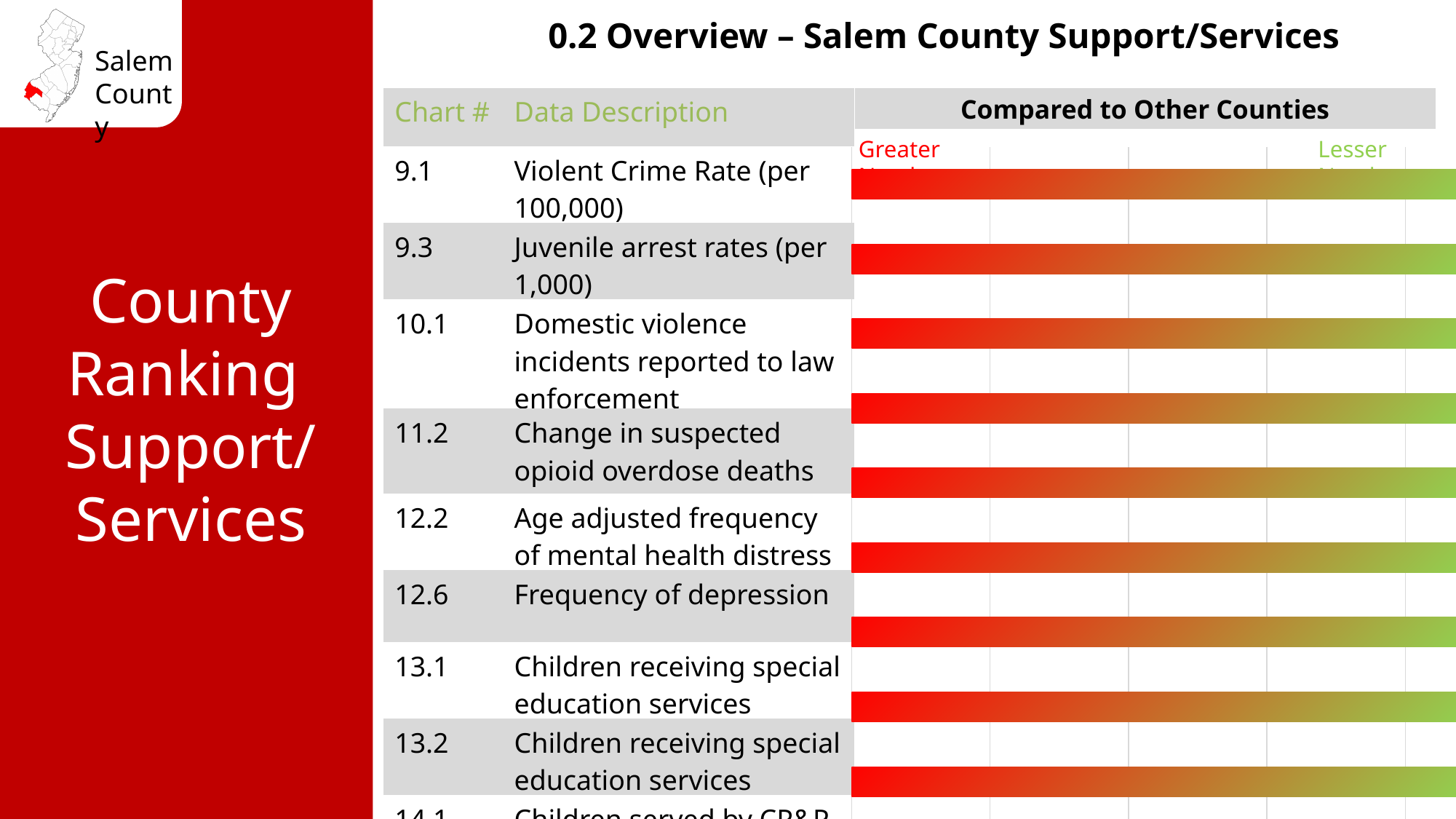
Which chart number is listed for 'Violent Crime Rate (per 100,000)'? 9.1 What is the heading above the gradient bars on the right side of the table? Compared to Other Counties What data description is listed for chart number 9.3? Juvenile arrest rates (per 1,000) What kind of chart is used in the 'Compared to Other Counties' column? bar chart Which chart number is listed for 'Change in suspected opioid overdose deaths'? 11.2 What data description is listed for chart number 10.1? Domestic violence incidents reported to law enforcement What is the title of the slide containing the chart? 0.2 Overview – Salem County Support/Services Which chart number is listed for 'Frequency of depression'? 12.6